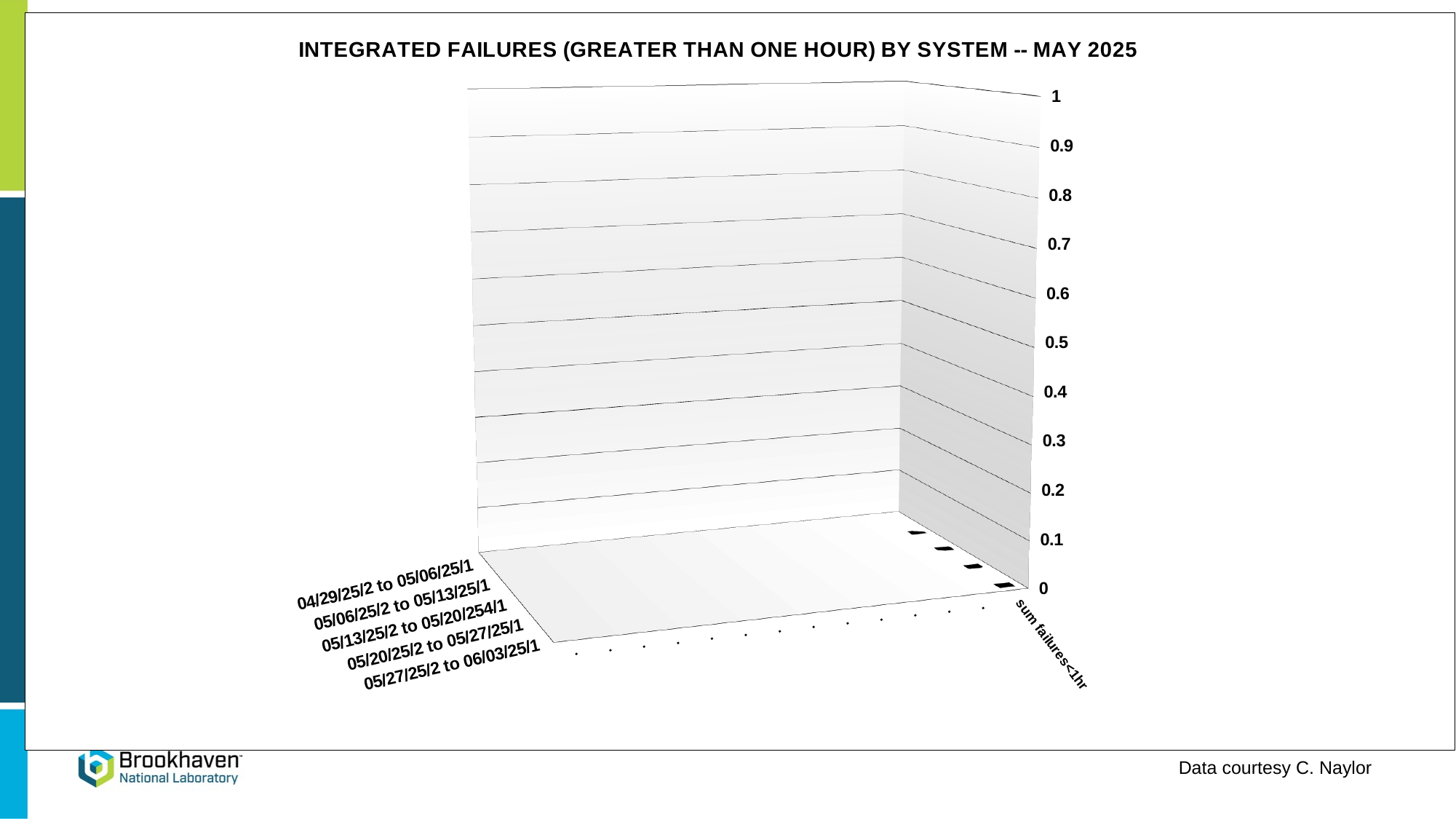
Is the value for 05/13/25/2 to 05/20/254/1 greater or less than 0.1? less Is the value for 05/27/25/2 to 06/03/25/1 greater or less than 0.5? less How many date-range categories are labelled along the front axis of the chart? 5 What kind of chart is shown on the slide? bar chart What is the title of the chart? INTEGRATED FAILURES (GREATER THAN ONE HOUR) BY SYSTEM -- MAY 2025 What label is printed along the right-hand depth axis of the chart? sum failures<1hr Is the value for 04/29/25/2 to 05/06/25/1 greater or less than 0.5? less